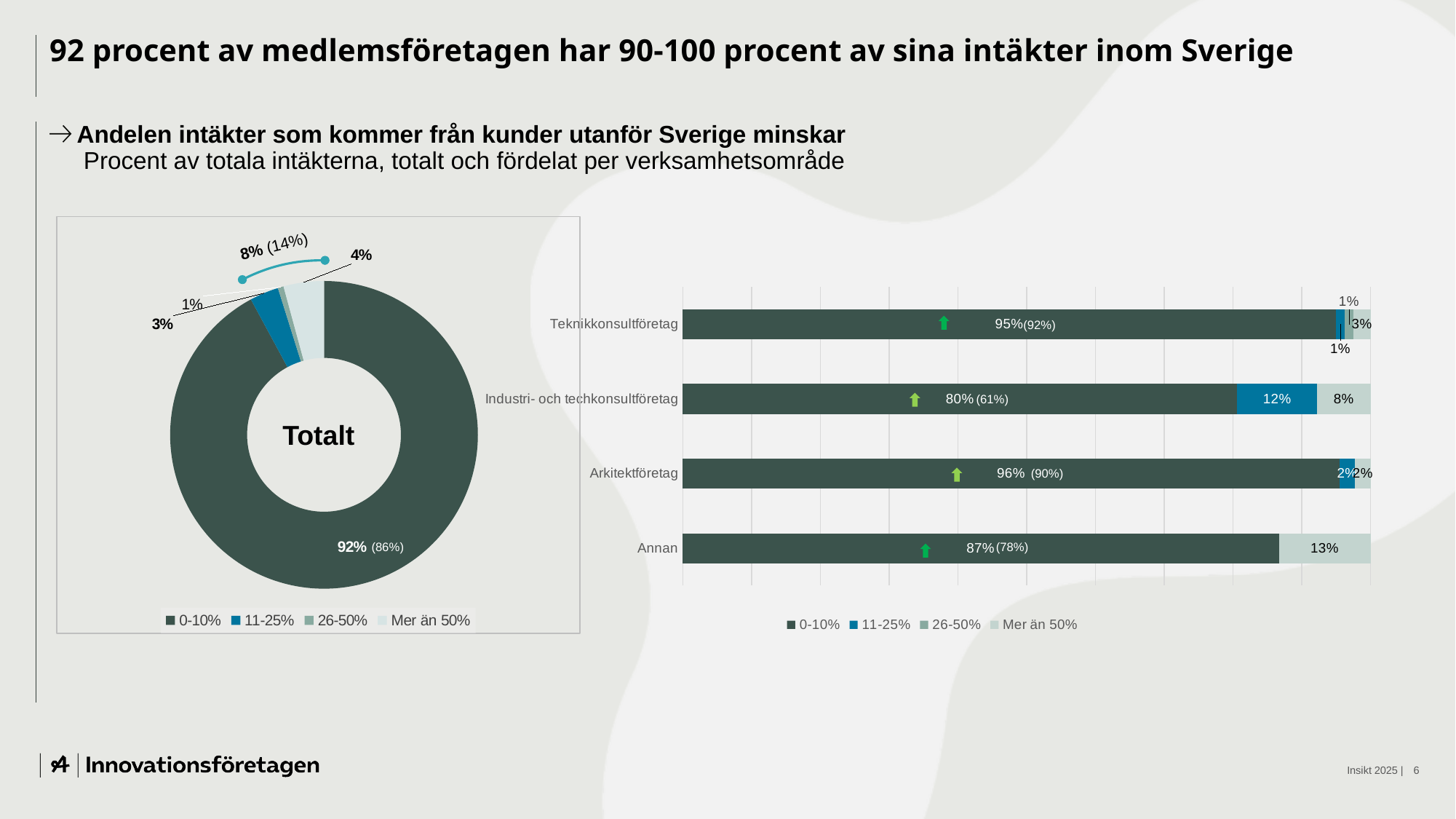
How many series does the legend of the bar chart on the right list? 4 In the bar chart on the right, what is the value of the Mer än 50% segment for Annan? 13% In the bar chart on the right, what is the difference between the 0-10% values for Arkitektföretag and Annan? 9% How many categories are shown in the bar chart on the right? 4 In the bar chart on the right, what is the value of the 11-25% segment for Industri- och techkonsultföretag? 12% In the bar chart on the right, what is the value of the 0-10% segment for Industri- och techkonsultföretag? 80% What kind of chart is the chart on the right of the slide? Bar chart In the bar chart on the right, which category has the lowest 0-10% value? Industri- och techkonsultföretag In the donut chart titled Totalt, what share does the 0-10% slice have? 92% In the bar chart on the right, which category has the highest 0-10% value? Arkitektföretag In the donut chart titled Totalt, what share does the Mer än 50% slice have? 4% In the bar chart on the right, which is larger: the 0-10% value for Teknikkonsultföretag or for Annan? Teknikkonsultföretag